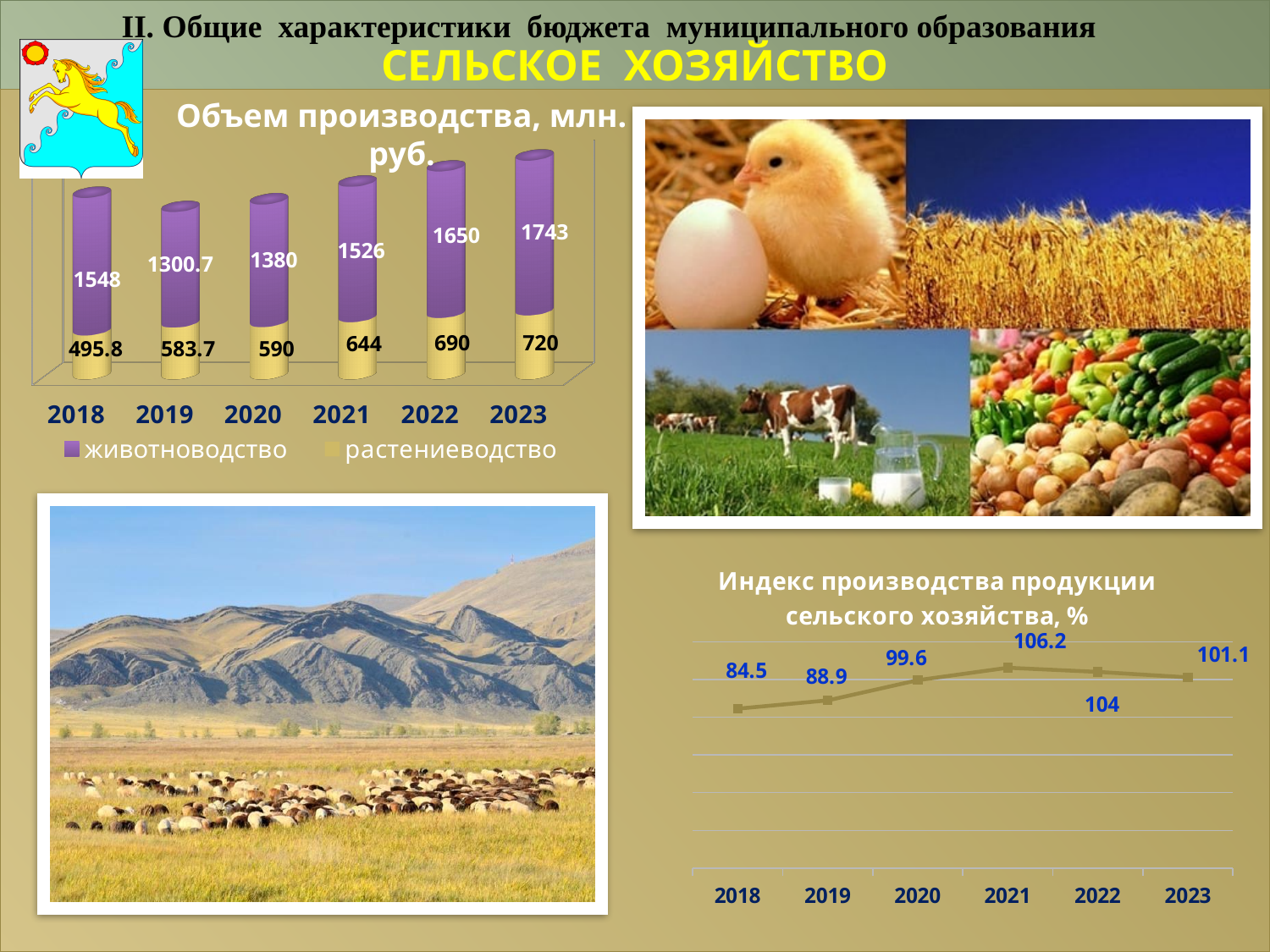
In the chart 'Индекс производства продукции сельского хозяйства, %', is the value for 2022 larger or smaller than the value for 2023? larger In the chart 'Объем производства, млн. руб.', how many series does the legend list? 2 What type of chart is 'Объем производства, млн. руб.'? bar chart In the chart 'Индекс производства продукции сельского хозяйства, %', what is the value for 2021? 106.2 In the chart 'Объем производства, млн. руб.', what is the value for растениеводство in 2019? 583.7 In the chart 'Объем производства, млн. руб.', which year has the highest value for растениеводство? 2023 In the chart 'Объем производства, млн. руб.', which year has the lowest value for животноводство? 2019 In the chart 'Объем производства, млн. руб.', what is the value for животноводство in 2023? 1743 In the chart 'Индекс производства продукции сельского хозяйства, %', which year has the lowest value? 2018 In the chart 'Индекс производства продукции сельского хозяйства, %', how many data points are plotted? 6 In the chart 'Объем производства, млн. руб.', what is the total of the stacked bar for 2023? 2463 In the chart 'Объем производства, млн. руб.', what is the difference between the растениеводство values for 2023 and 2022? 30